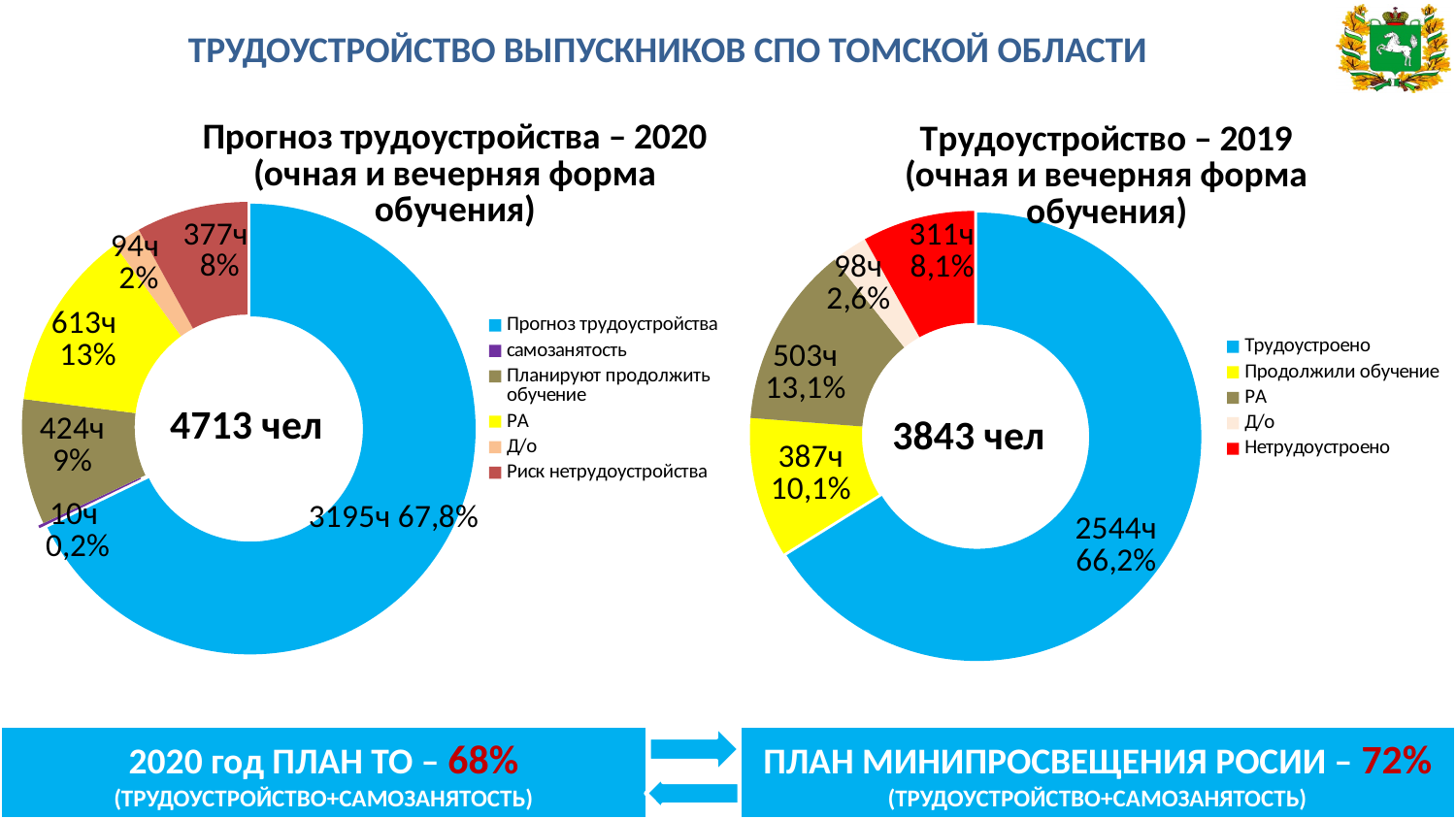
What total number of people is shown in the centre of the right chart (Трудоустройство – 2019)? 3843 чел In the left chart (Прогноз трудоустройства – 2020), which category has the smallest slice? самозанятость In the right chart (Трудоустройство – 2019), which category has the smallest slice? Д/о In the left chart (Прогноз трудоустройства – 2020), how many people are in the Прогноз трудоустройства slice? 3195ч In the right chart (Трудоустройство – 2019), what percentage is shown for Нетрудоустроено? 8,1% In the right chart (Трудоустройство – 2019), which category has the largest slice? Трудоустроено In the right chart (Трудоустройство – 2019), which is larger: Продолжили обучение or РА? РА How many categories does the legend of the left chart (Прогноз трудоустройства – 2020) list? 6 In the left chart (Прогноз трудоустройства – 2020), what percentage is shown for РА? 13% In the left chart (Прогноз трудоустройства – 2020), what is the difference in people between РА and Планируют продолжить обучение? 189ч In the right chart (Трудоустройство – 2019), how many people are in the РА slice? 503ч In the left chart (Прогноз трудоустройства – 2020), what is the value for самозанятость? 10ч